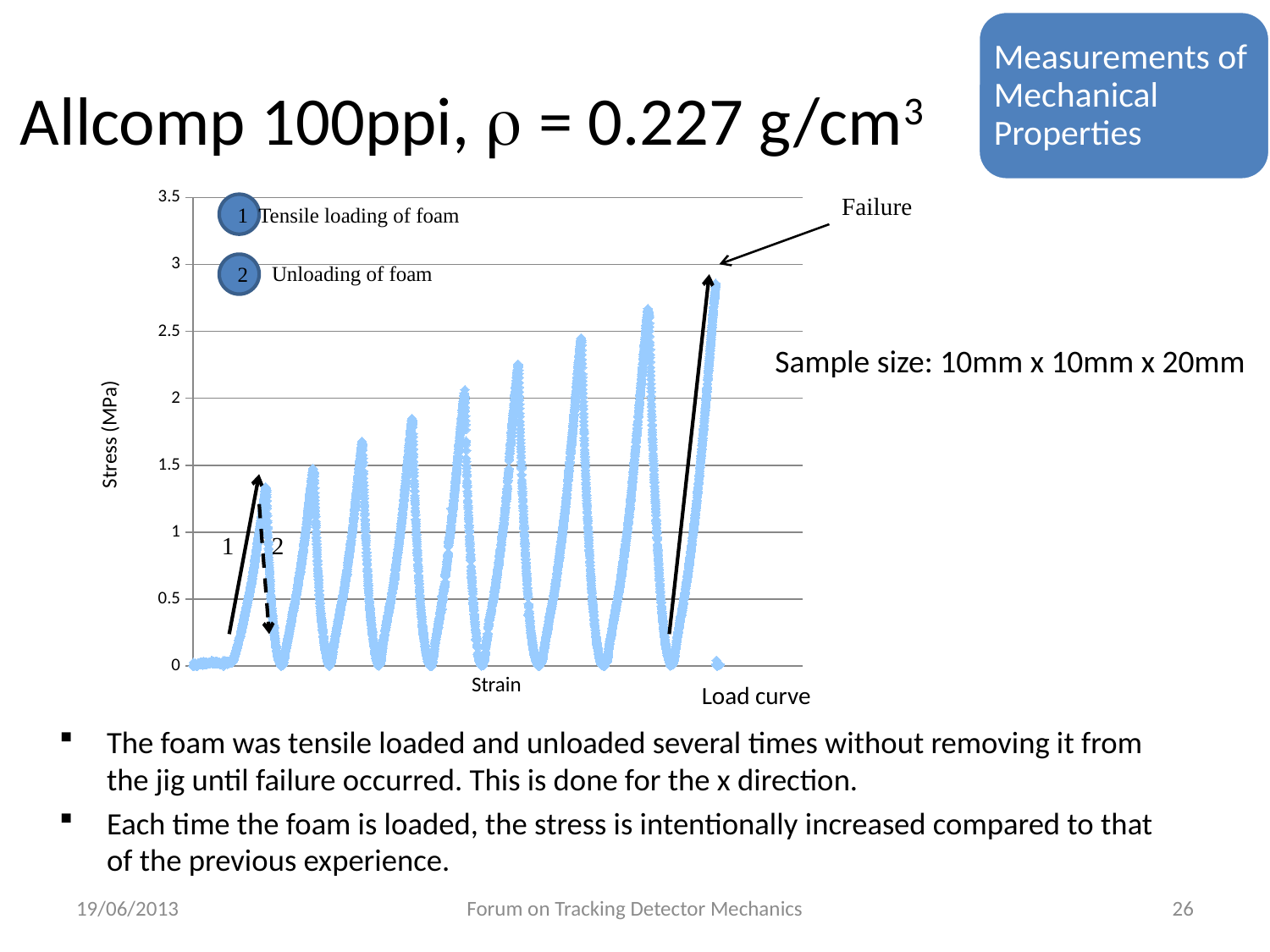
Is the highest stress reached before failure greater or less than 2.5 MPa? greater What is the highest value shown on the y axis of the chart? 3.5 Do the peak stress values of the loading cycles rise or fall along the x axis? rise What is the label of the x axis of the chart? Strain What kind of chart is shown on the slide? scatter chart How many loading peaks are visible in the load curve? 9 Is the peak stress of the first loading cycle greater or less than 1 MPa? greater Is the highest stress reached before failure greater or less than 3 MPa? less Which loading cycle reaches the higher peak stress, the first or the last? the last How many series does the chart's legend list? 1 What is the label of the y axis of the chart? Stress (MPa)